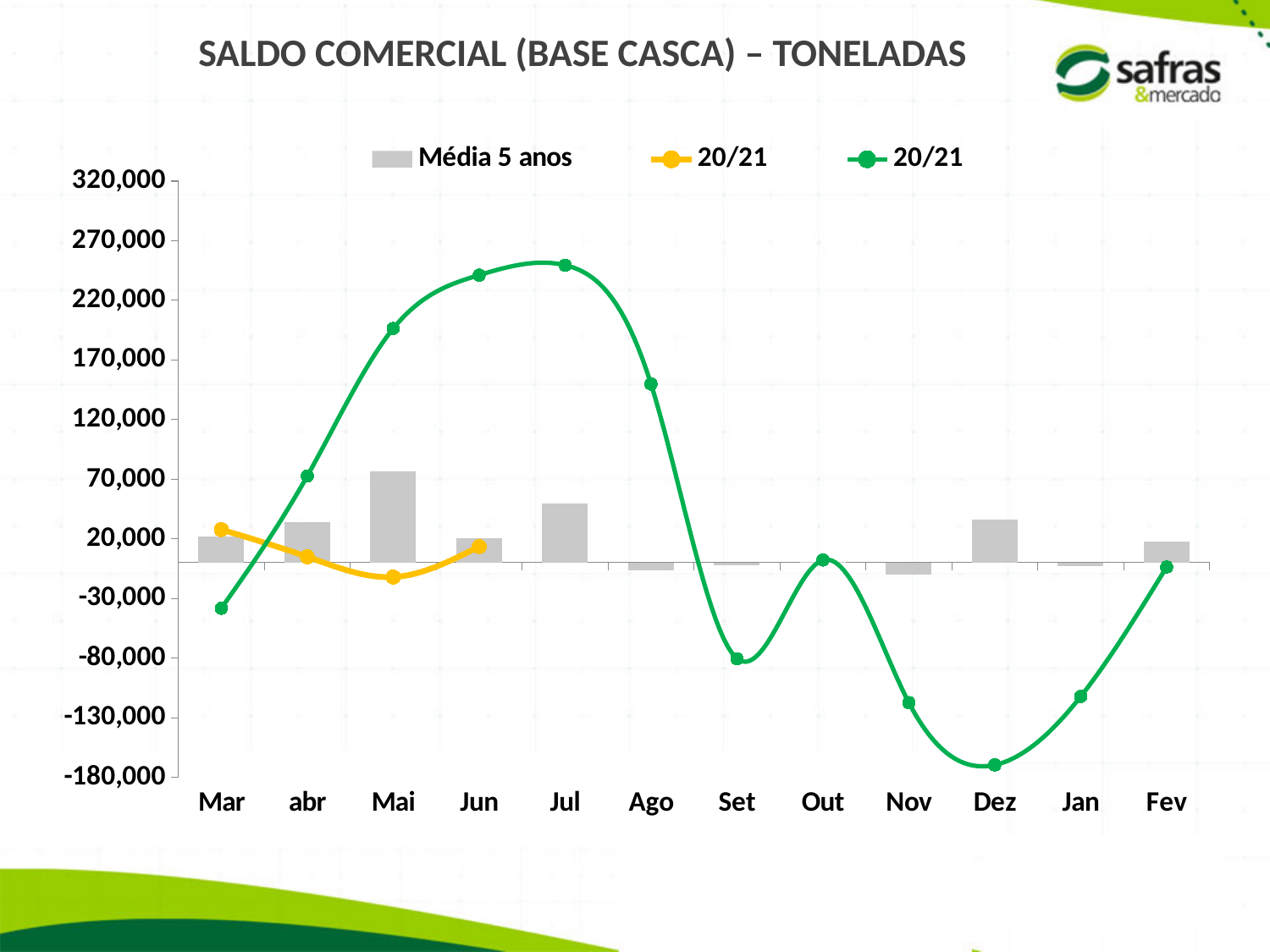
Which series is drawn as gray bars? Média 5 anos What is the title of the chart? SALDO COMERCIAL (BASE CASCA) – TONELADAS Which is larger in Mai: the green 20/21 line or the Média 5 anos bar? The green 20/21 line What kind of chart is shown on the slide? A combined bar and line chart How many series does the legend list? 3 Is the value of the green 20/21 line for Dez greater or less than -130,000? less In which month is the Média 5 anos bar the highest? Mai How many months are shown on the x axis? 12 In which month does the yellow 20/21 line reach its lowest value? Mai Does the green 20/21 line rise or fall from Mar to Jun? Rise Is the value of the green 20/21 line for Mai greater or less than 170,000? greater In which month does the green 20/21 line reach its lowest value? Dez